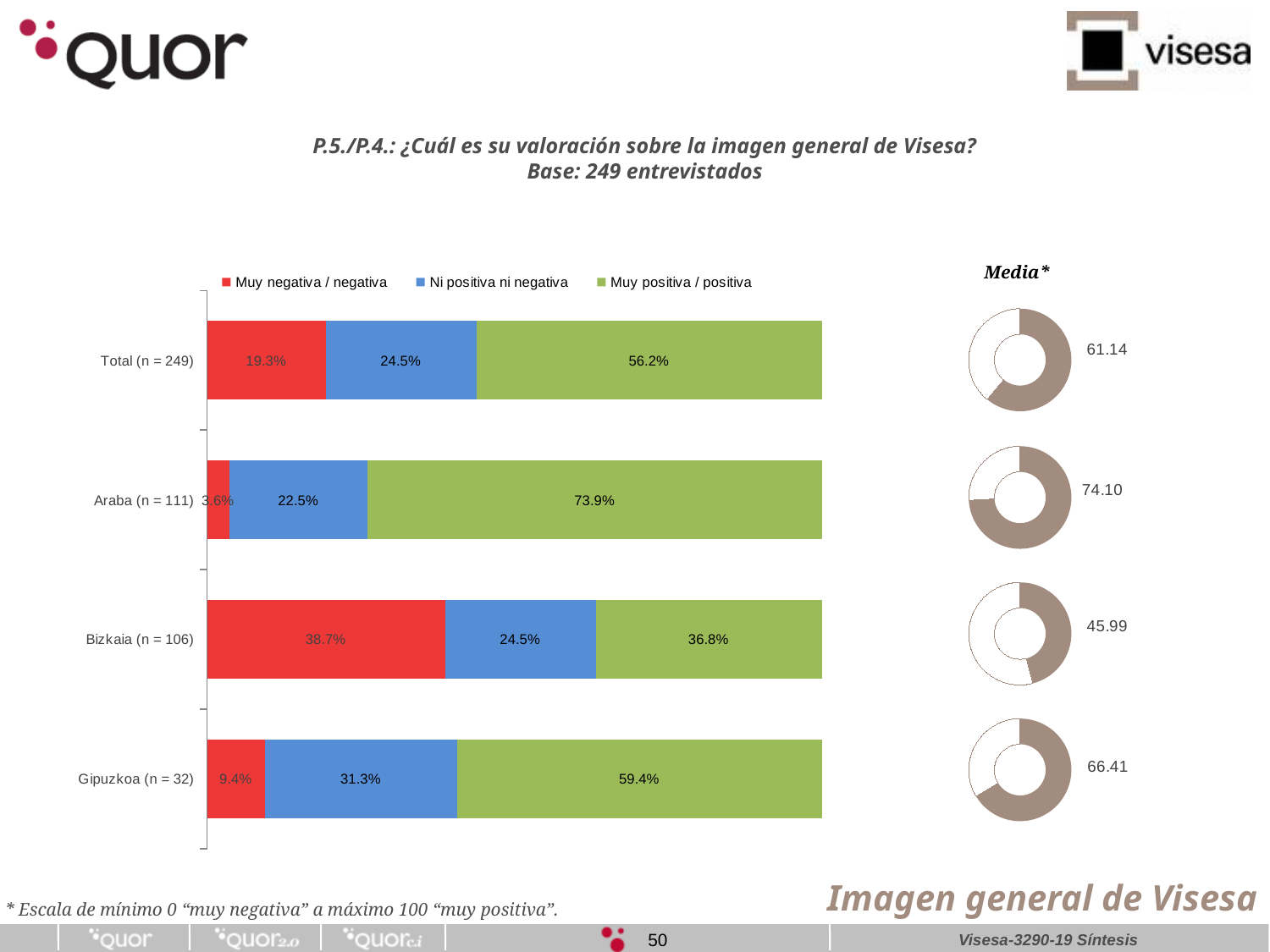
How many categories are shown in the stacked bar chart? 4 In the stacked bar chart, what is the difference between the "Muy positiva / positiva" values for Araba (n = 111) and Bizkaia (n = 106)? 37.1% How many series does the legend of the stacked bar chart list? 3 In the Media* donut charts on the right, which category has the highest mean value? Araba (n = 111) In the stacked bar chart, what percentage of Total (n = 249) respondents answered "Muy positiva / positiva"? 56.2% In the stacked bar chart, what is the "Muy negativa / negativa" value for Bizkaia (n = 106)? 38.7% In the Media* donut charts on the right, what is the mean value shown for Bizkaia (n = 106)? 45.99 In the stacked bar chart, which is larger: the "Ni positiva ni negativa" value for Gipuzkoa (n = 32) or for Araba (n = 111)? Gipuzkoa (n = 32) In the stacked bar chart, which category has the highest "Muy positiva / positiva" value? Araba (n = 111) What kind of chart is the main chart on the left of the slide? Stacked bar chart In the stacked bar chart, which category has the lowest "Muy negativa / negativa" value? Araba (n = 111) In the stacked bar chart, what is the "Ni positiva ni negativa" value for Gipuzkoa (n = 32)? 31.3%